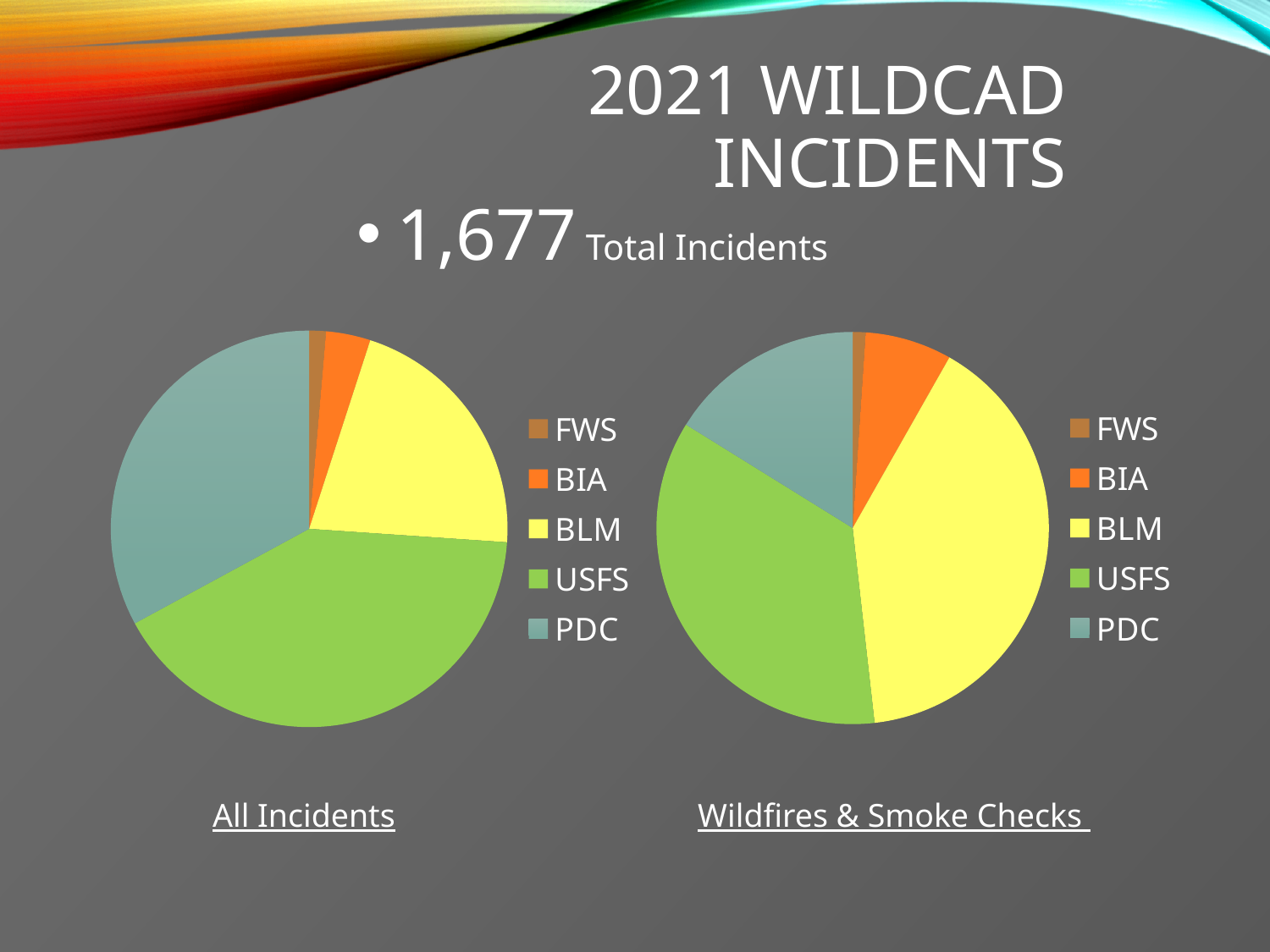
What kind of chart is the All Incidents chart? pie chart How many slices does the All Incidents pie chart have? 5 How many entries does the legend of the Wildfires & Smoke Checks chart list? 5 What is the label under the right-hand pie chart? Wildfires & Smoke Checks In the All Incidents pie chart, which agency has the largest slice? USFS What are the legend entries of the All Incidents pie chart? FWS, BIA, BLM, USFS, PDC In the Wildfires & Smoke Checks pie chart, which slice is larger, BLM or PDC? BLM In the All Incidents pie chart, which slice is larger, USFS or BIA? USFS In the Wildfires & Smoke Checks pie chart, which slice is larger, USFS or FWS? USFS In the Wildfires & Smoke Checks pie chart, which agency has the smallest slice? FWS In the All Incidents pie chart, which agency has the smallest slice? FWS